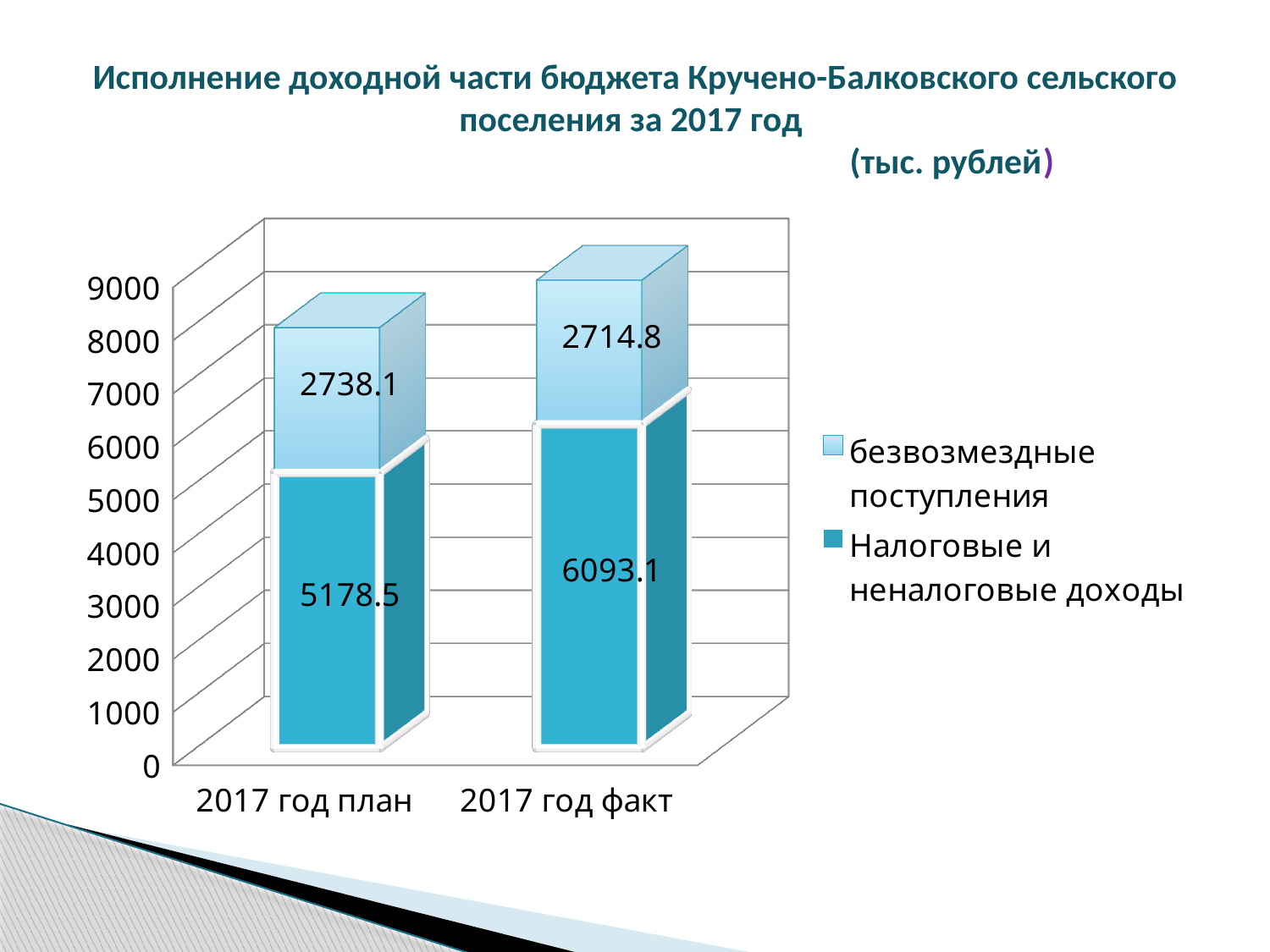
What is the value of Налоговые и неналоговые доходы for 2017 год факт? 6093.1 What is the value of Налоговые и неналоговые доходы for 2017 год план? 5178.5 How many series does the legend list? 2 What is the total of the stacked bar for 2017 год план? 7916.6 What is the total of the stacked bar for 2017 год факт? 8807.9 What kind of chart is shown on the slide? Stacked bar chart What is the difference between the Налоговые и неналоговые доходы values for 2017 год факт and 2017 год план? 914.6 How many categories are shown on the x axis? 2 Which category has the higher value for Налоговые и неналоговые доходы, 2017 год план or 2017 год факт? 2017 год факт What is the value of безвозмездные поступления for 2017 год факт? 2714.8 What is the value of безвозмездные поступления for 2017 год план? 2738.1 What is the difference between the безвозмездные поступления values for 2017 год план and 2017 год факт? 23.3